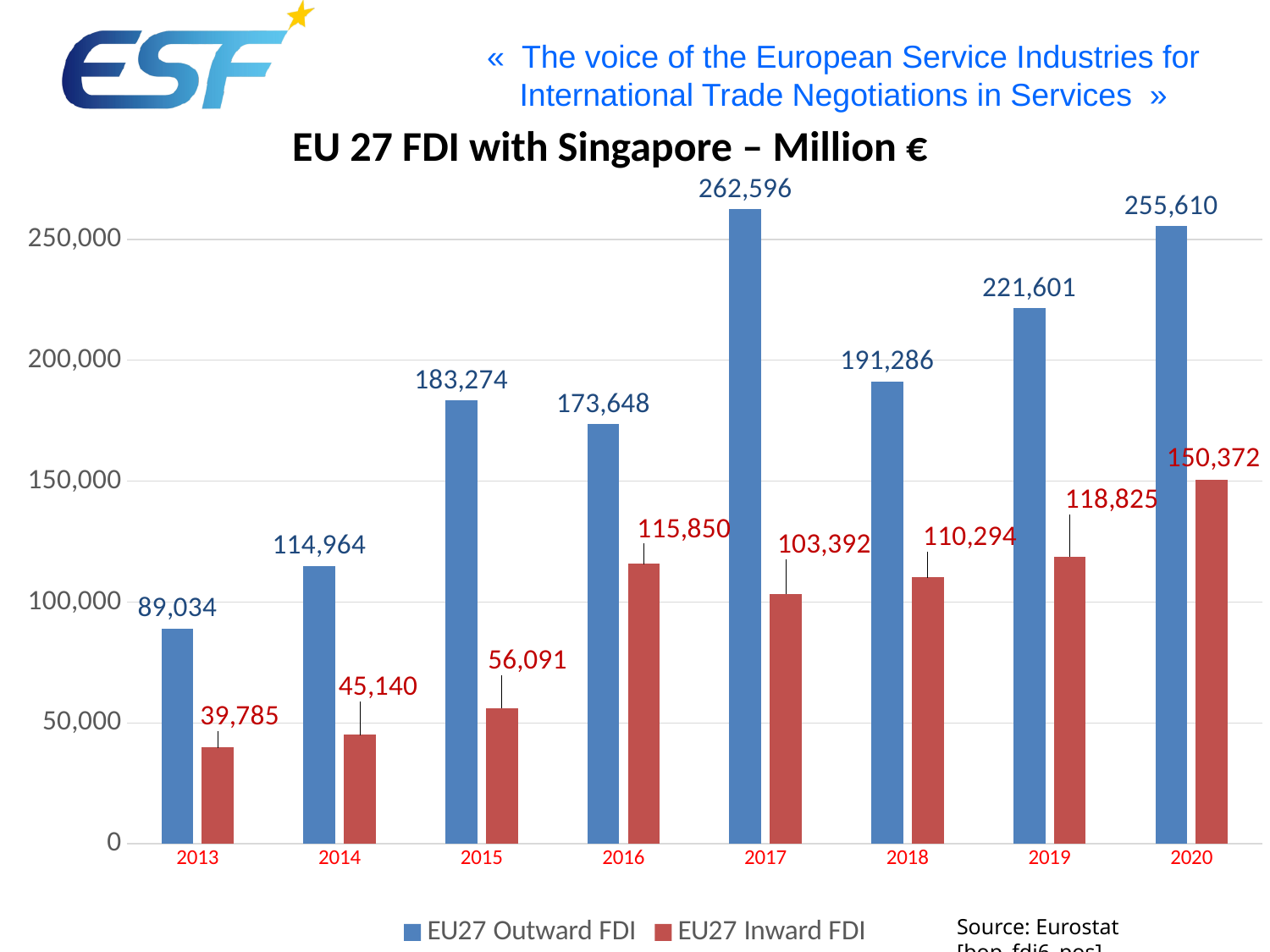
What is the EU27 Inward FDI value for 2013? 39,785 What kind of chart is shown on the slide? Bar chart How many series does the legend list? 2 In which year is EU27 Inward FDI lowest? 2013 What is the title of the chart? EU 27 FDI with Singapore – Million € What is the EU27 Outward FDI value for 2017? 262,596 What is the difference between EU27 Outward FDI and EU27 Inward FDI in 2020? 105,238 What is the EU27 Inward FDI value for 2020? 150,372 Which is larger: EU27 Outward FDI in 2015 or in 2016? 2015 Is the EU27 Inward FDI value for 2019 greater or less than 100,000? greater In which year is EU27 Outward FDI highest? 2017 How many years are shown on the x axis? 8